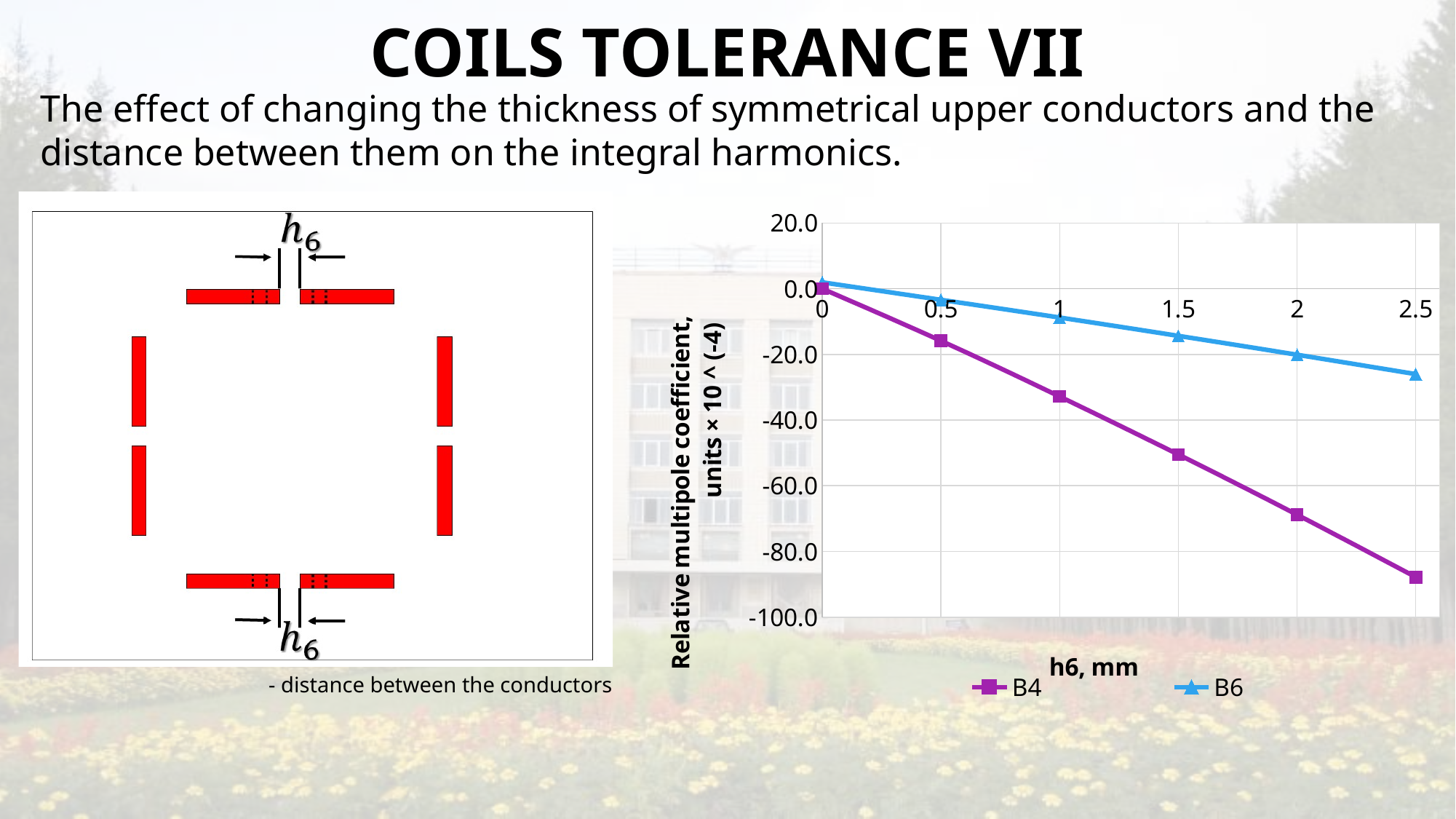
How many data points are plotted for the B4 series? 6 Which series are listed in the chart legend? B4 and B6 Is the B6 value at h6 = 1 mm greater or less than -20.0? greater At h6 = 2.5 mm, which series has the higher value, B4 or B6? B6 What kind of chart is shown on the slide? line chart How many series does the chart legend list? 2 Is the B4 value at h6 = 2.5 mm greater or less than -80.0? less Is the B4 value at h6 = 1.5 mm greater or less than -40.0? less What is the title of the x axis of the chart? h6, mm Do the B4 values rise or fall as h6 increases from 0 to 2.5 mm? fall Do the B6 values rise or fall as h6 increases along the x axis? fall